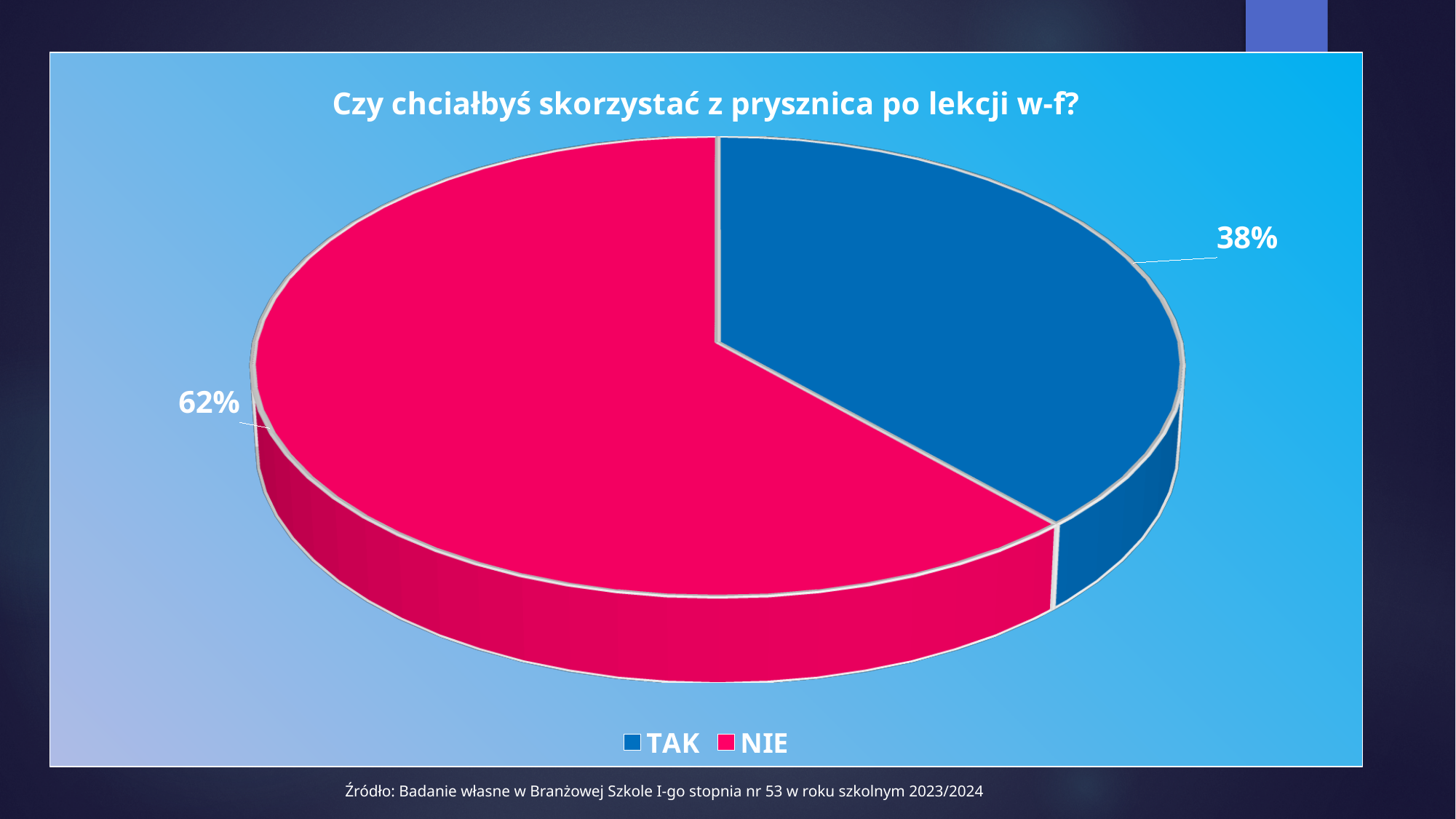
Which slice is larger, TAK or NIE? NIE What is the title of the chart? Czy chciałbyś skorzystać z prysznica po lekcji w-f? What percentage of respondents answered NIE? 62% How many slices does the pie chart have? 2 What colour is the NIE slice? Pink/red Which answer has the largest share of the pie? NIE Which answer has the smallest share of the pie? TAK What share of the pie does the TAK slice represent? 38% What percentage of respondents answered TAK? 38% What is the difference in percentage points between the NIE and TAK slices? 24 What kind of chart is shown on the slide? Pie chart How many entries does the legend list? 2